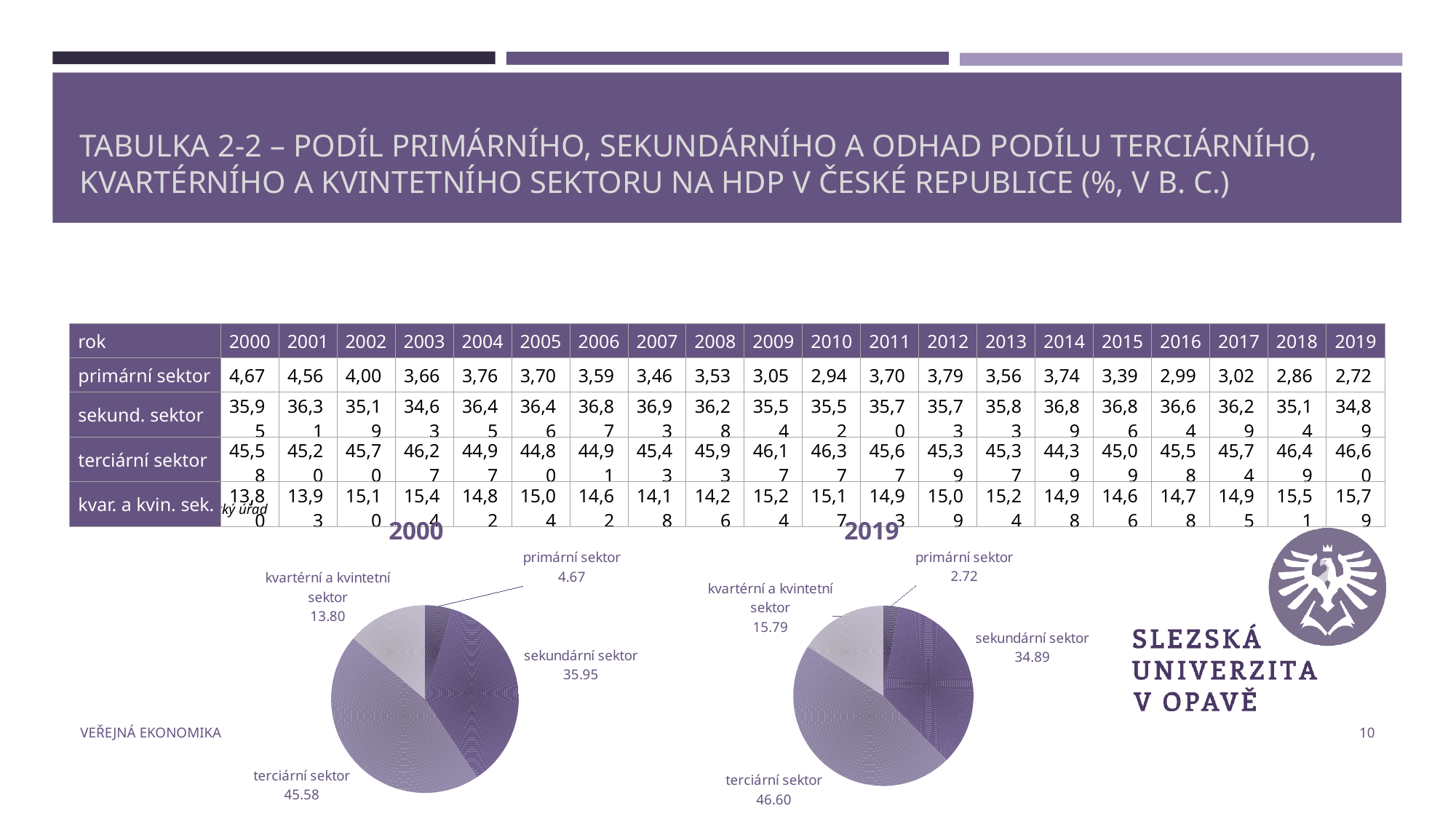
In the pie chart titled 2019, what is the value for primární sektor? 2.72 How many slices does the pie chart titled 2019 have? 4 In the pie chart titled 2000, what is the value for terciární sektor? 45.58 In the pie chart titled 2019, which sector has the smallest slice? primární sektor Which is larger: primární sektor in the 2000 pie chart or primární sektor in the 2019 pie chart? 2000 In the pie chart titled 2019, what is the difference between terciární sektor and sekundární sektor? 11.71 In the pie chart titled 2019, what is the value for sekundární sektor? 34.89 How many pie charts are shown on the slide? 2 In the pie chart titled 2000, what is the value for kvartérní a kvintetní sektor? 13.80 In the pie chart titled 2000, which sector has the largest slice? terciární sektor What type of chart is the chart titled 2000? pie chart In the pie chart titled 2000, what is the difference between sekundární sektor and kvartérní a kvintetní sektor? 22.15